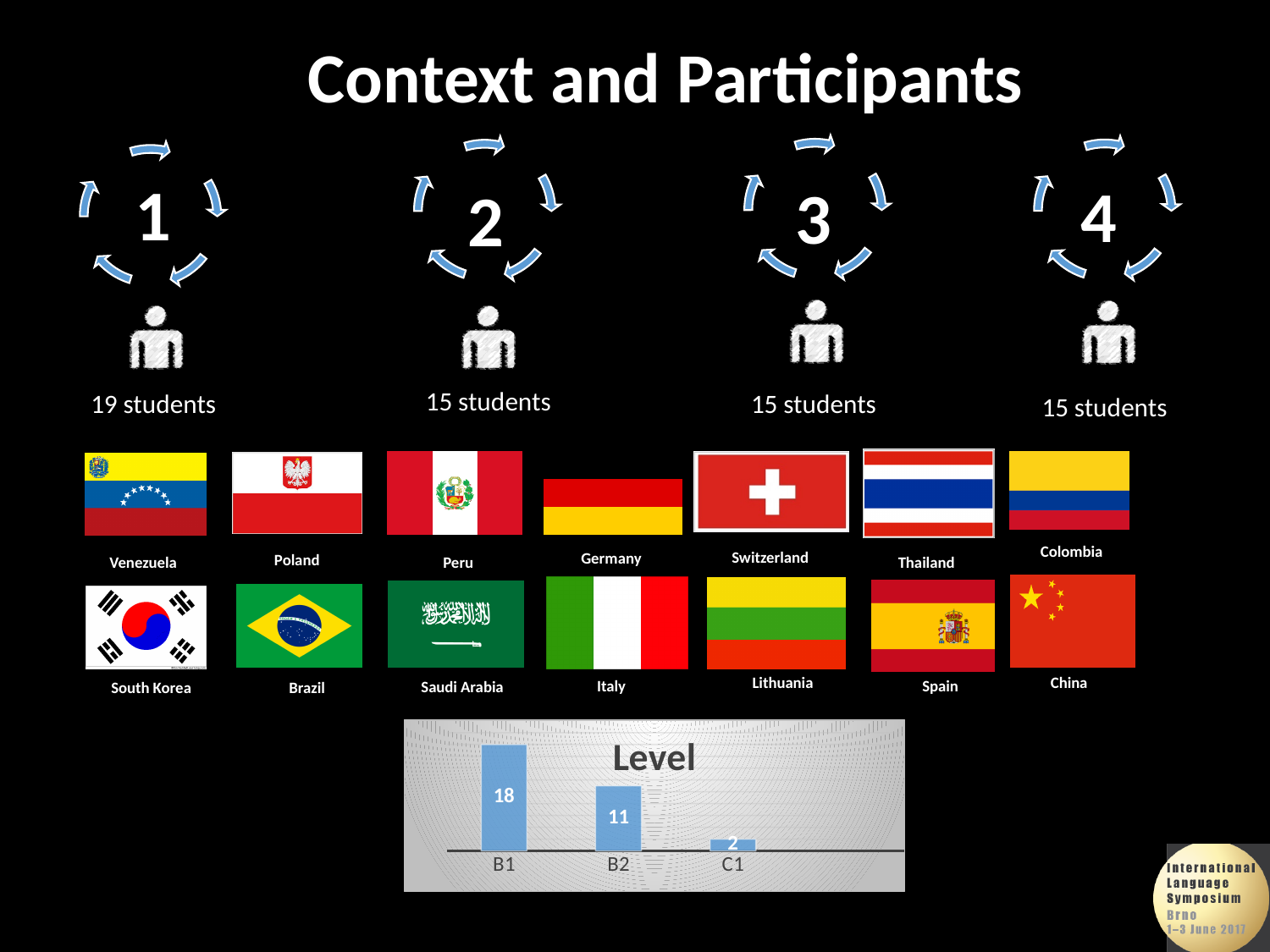
What is the difference between the values for B1 and B2 in the Level chart? 7 What is the difference between the values for B2 and C1 in the Level chart? 9 Which level has the highest value in the Level chart? B1 How many categories are shown in the Level chart? 3 What kind of chart is the Level chart? bar chart What is the value for B2 in the Level chart? 11 What is the title of the chart on the slide? Level Do the values in the Level chart rise or fall from B1 to C1? fall What is the value for C1 in the Level chart? 2 Which level has the lowest value in the Level chart? C1 What is the value for B1 in the Level chart? 18 Which is larger in the Level chart, the value for B1 or the value for C1? B1